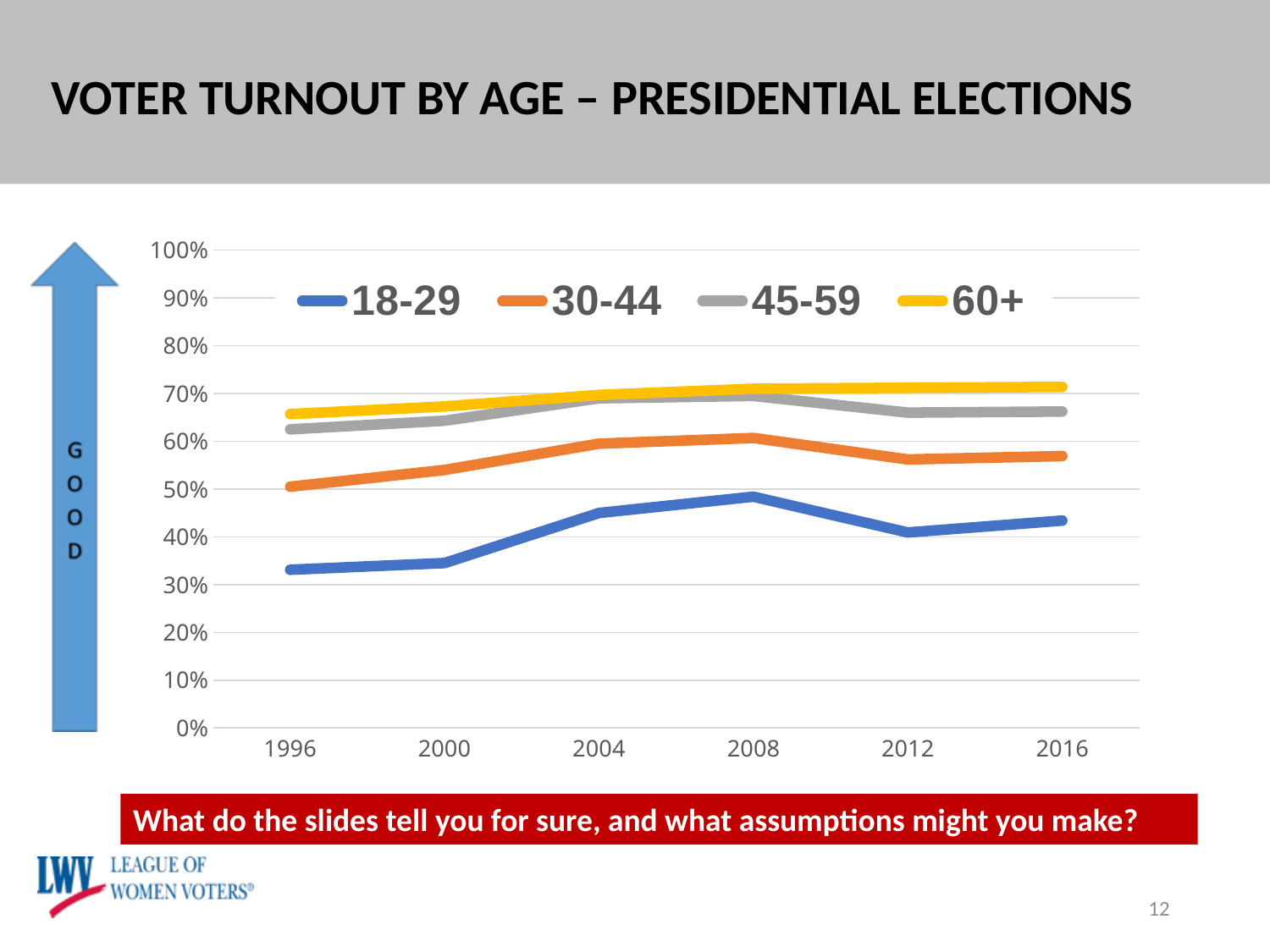
In which year does the 18-29 group reach its highest turnout? 2008 Which age group has the lowest voter turnout in 1996? 18-29 Is the value for the 18-29 group in 1996 greater or less than 40%? less How many election years are shown on the x axis? 6 Which age group has the highest voter turnout in 2016? 60+ How many series does the legend list? 4 Is the value for the 30-44 group in 2004 greater or less than 50%? greater Is the value for the 60+ group in 1996 greater or less than 60%? greater Does the turnout for the 18-29 group rise or fall from 1996 to 2008? rise For the 18-29 group, which year has the higher turnout, 2008 or 2012? 2008 What kind of chart is shown on the slide? line chart What is the title of the slide containing the chart? VOTER TURNOUT BY AGE – PRESIDENTIAL ELECTIONS